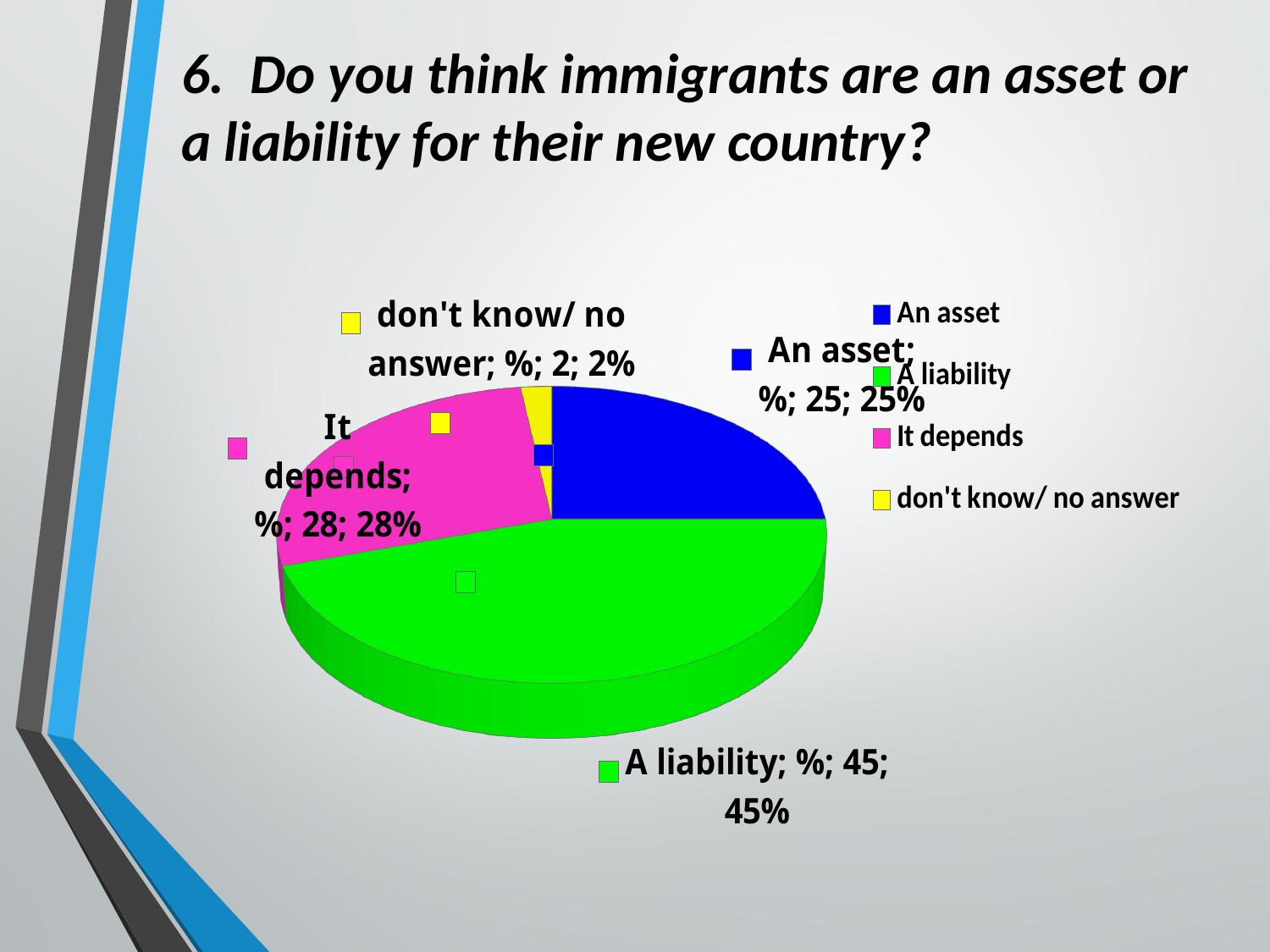
How many percentage points higher is "A liability" than "An asset"? 20 Which response has the smallest share of the pie? don't know/ no answer Which legend entry is shown in yellow? don't know/ no answer Which response has the largest share of the pie? A liability Which is larger, the share for "It depends" or the share for "An asset"? It depends What percentage of respondents answered "don't know/ no answer"? 2% What percentage of respondents answered "It depends"? 28% What percentage of respondents answered "A liability"? 45% How many slices does the pie chart have? 4 What kind of chart is shown on the slide? pie chart What colour is the slice for "A liability"? green What percentage of respondents answered "An asset"? 25%